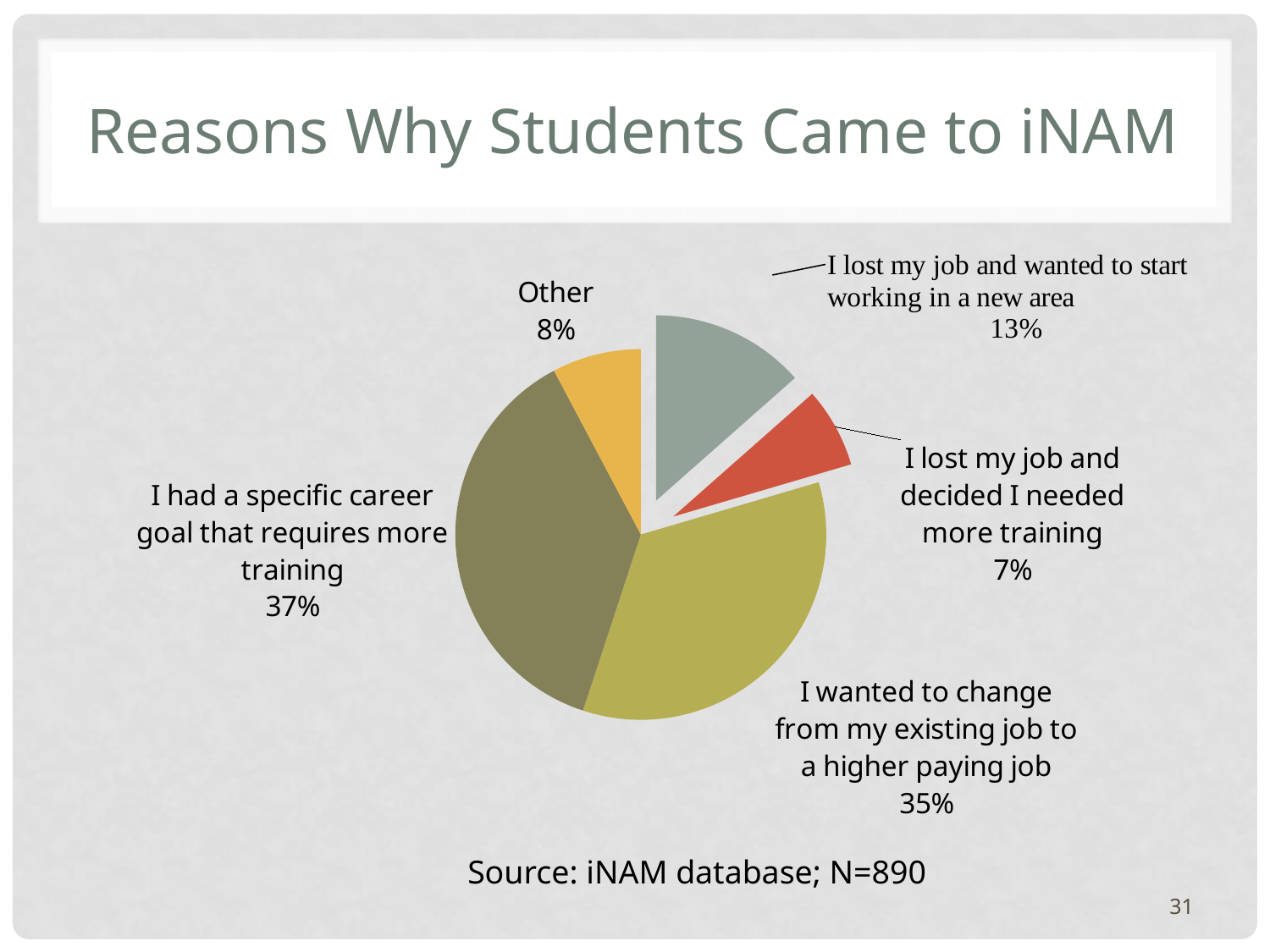
Which reason has the smallest share of the pie? I lost my job and decided I needed more training What share of students said they wanted to change from their existing job to a higher paying job? 35% Which is larger: the share for 'Other' or the share for 'I lost my job and decided I needed more training'? Other What kind of chart is shown on the slide? Pie chart What share of students said they lost their job and wanted to start working in a new area? 13% What share of students gave 'Other' as their reason? 8% Which reason has the largest share of the pie? I had a specific career goal that requires more training What is the difference in percentage points between 'I lost my job and wanted to start working in a new area' and 'I lost my job and decided I needed more training'? 6 percentage points What is the title of the chart on the slide? Reasons Why Students Came to iNAM How many slices does the pie chart have? 5 What share of students said they had a specific career goal that requires more training? 37% What share of students said they lost their job and decided they needed more training? 7%